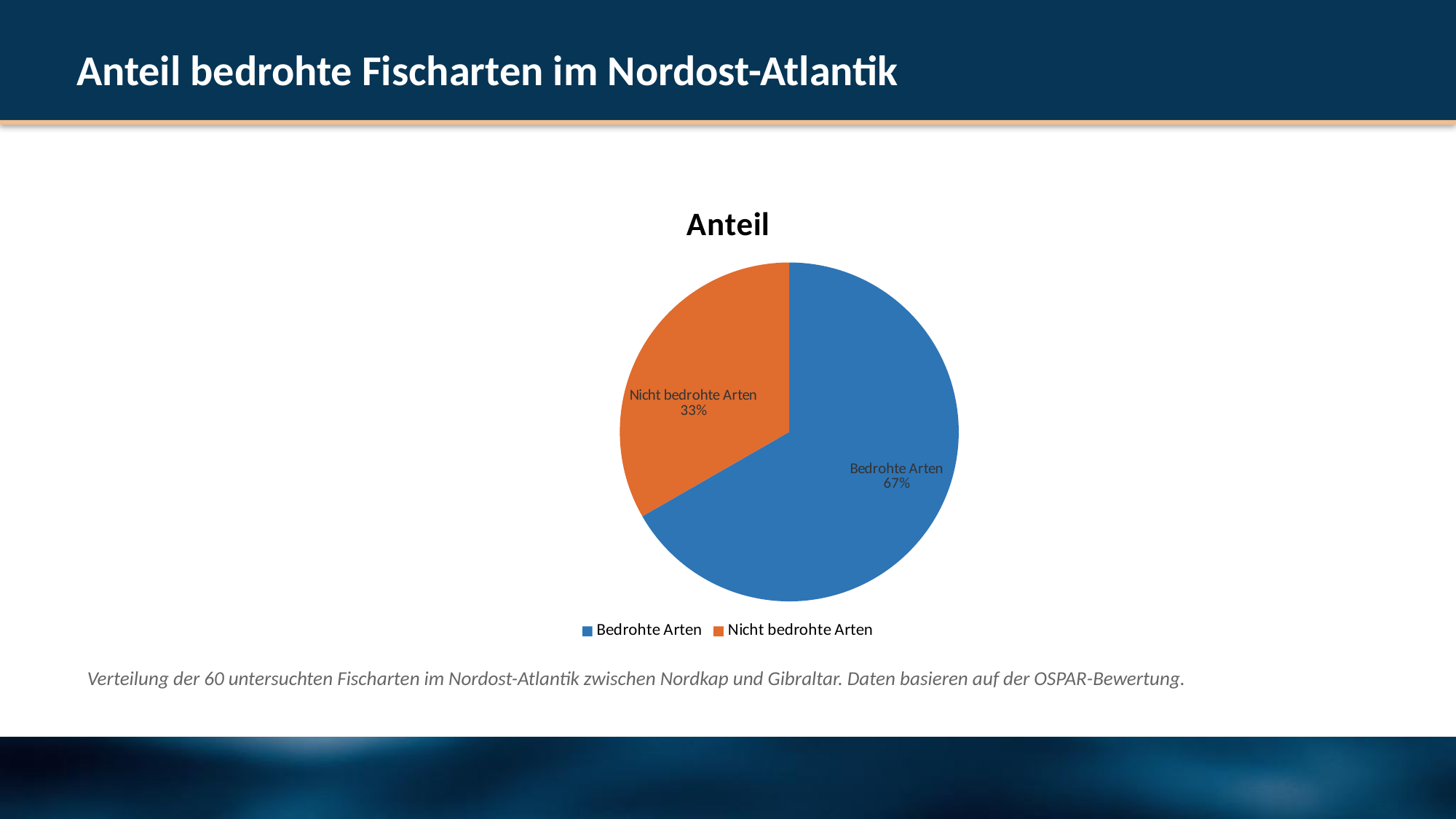
Which is larger, the Bedrohte Arten slice or the Nicht bedrohte Arten slice? Bedrohte Arten Which slice is the smallest? Nicht bedrohte Arten How many slices does the pie chart have? 2 What is the difference in percentage points between the Bedrohte Arten and Nicht bedrohte Arten slices? 34 percentage points Which colour represents Nicht bedrohte Arten? orange What share of the pie is labelled Nicht bedrohte Arten? 33% What kind of chart is shown on the slide? pie chart What share of the pie is labelled Bedrohte Arten? 67% Is the share for Bedrohte Arten greater or less than 50%? greater Which slice is the largest? Bedrohte Arten How many entries does the legend list? 2 What is the chart's title? Anteil